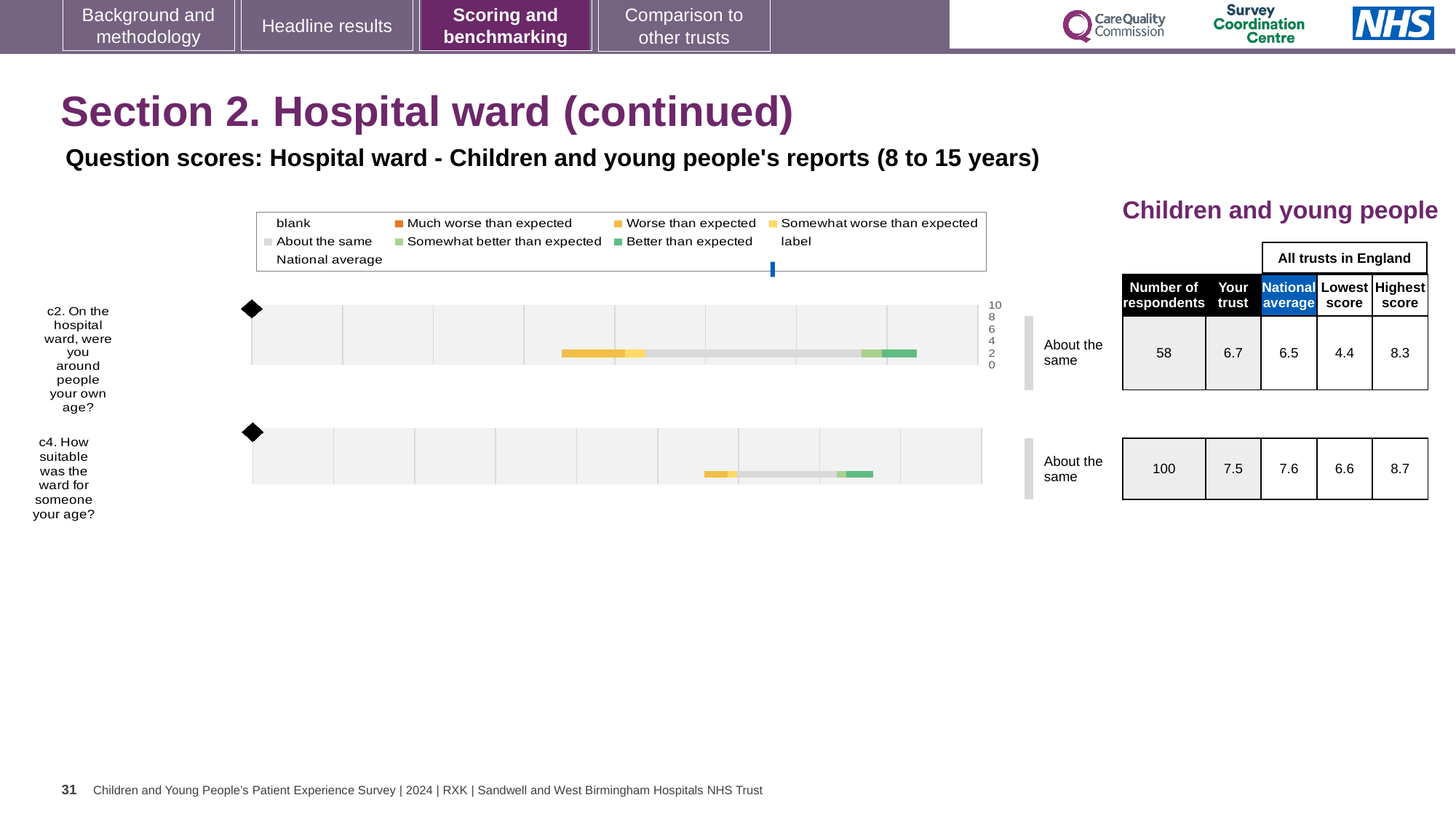
How many respondents answered c4? 100 Which question has the higher 'Your trust' score, c2 or c4? c4 How many questions are plotted on the slide? 2 What is the national average score for c4 (How suitable was the ward for someone your age?)? 7.6 What is the difference between the highest score and the lowest score for c2? 3.9 What is the difference between the national average and the 'Your trust' score for c4? 0.1 What is the lowest score across all trusts in England for c4? 6.6 What benchmark category is shown for c2? About the same What is the 'Your trust' score for c2 (On the hospital ward, were you around people your own age?)? 6.7 Which question has more respondents, c2 or c4? c4 What kind of chart is used to show the question scores for c2 and c4? bar chart Which legend entry is shown in dark green? Better than expected